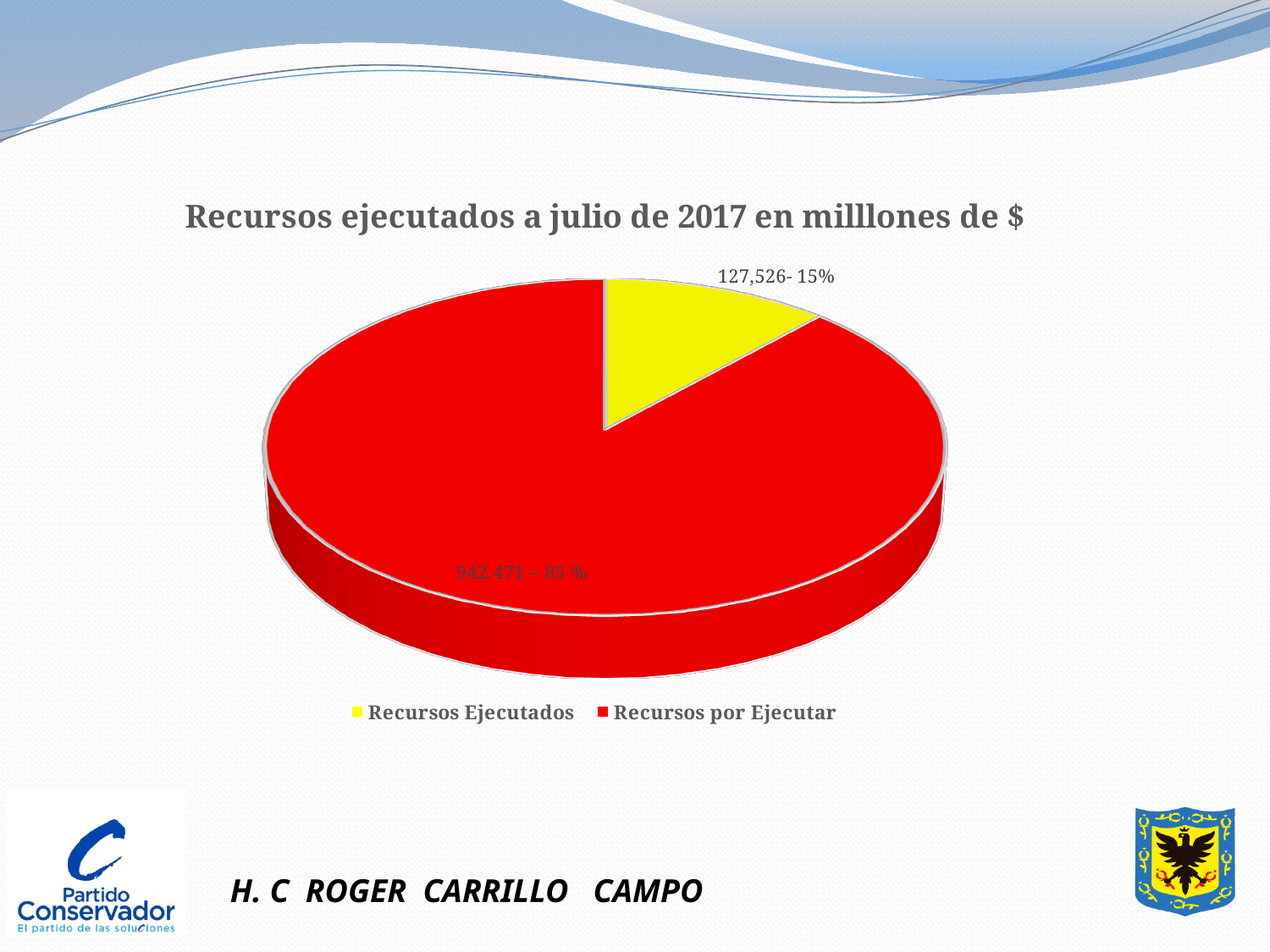
Which slice of the pie chart is the largest? Recursos por Ejecutar What value is printed for the Recursos Ejecutados slice? 127,526 Which is larger, Recursos Ejecutados or Recursos por Ejecutar? Recursos por Ejecutar What share of the pie does Recursos Ejecutados represent? 15% How many slices does the pie chart have? 2 How many entries does the legend of the pie chart list? 2 What value is printed for the Recursos por Ejecutar slice? 942.471 What kind of chart is shown on the slide? Pie chart What is the title of the pie chart? Recursos ejecutados a julio de 2017 en milllones de $ Which slice of the pie chart is the smallest? Recursos Ejecutados What share of the pie does Recursos por Ejecutar represent? 85 % What colour is the Recursos Ejecutados slice? Yellow